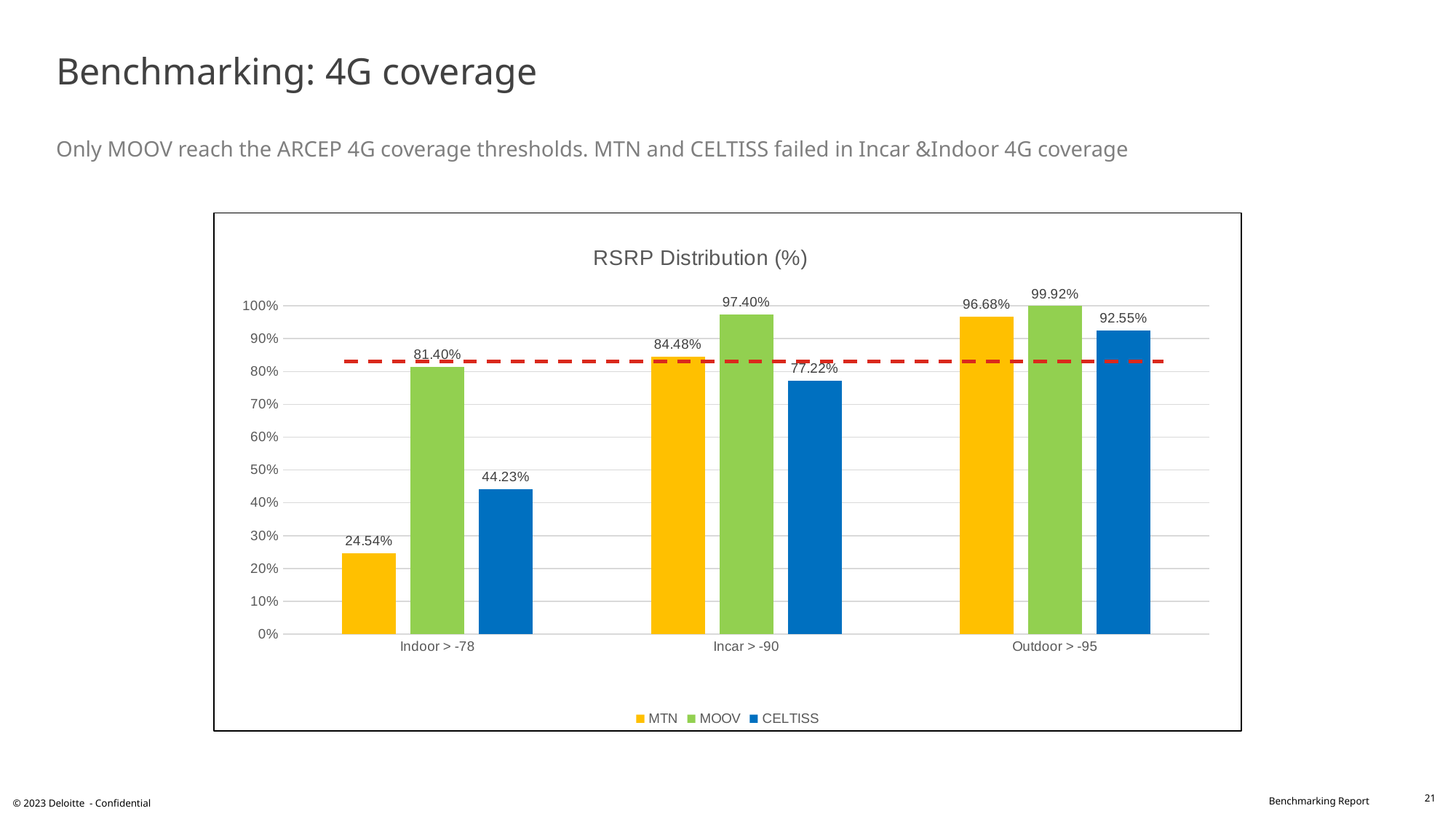
Which operator has the highest value in the Indoor > -78 category? MOOV How many categories are shown on the x axis? 3 Which is larger: MTN in Incar > -90 or CELTISS in Incar > -90? MTN in Incar > -90 What is the value for CELTISS in the Incar > -90 category? 77.22% How many series does the legend list? 3 What is the title of the chart? RSRP Distribution (%) What is the value for MTN in the Indoor > -78 category? 24.54% What is the value for MOOV in the Outdoor > -95 category? 99.92% Is the value for CELTISS in the Indoor > -78 category greater or less than 50%? less Which operator has the lowest value in the Outdoor > -95 category? CELTISS What kind of chart is shown on the slide? Bar chart What is the difference between MOOV and CELTISS in the Indoor > -78 category? 37.17%